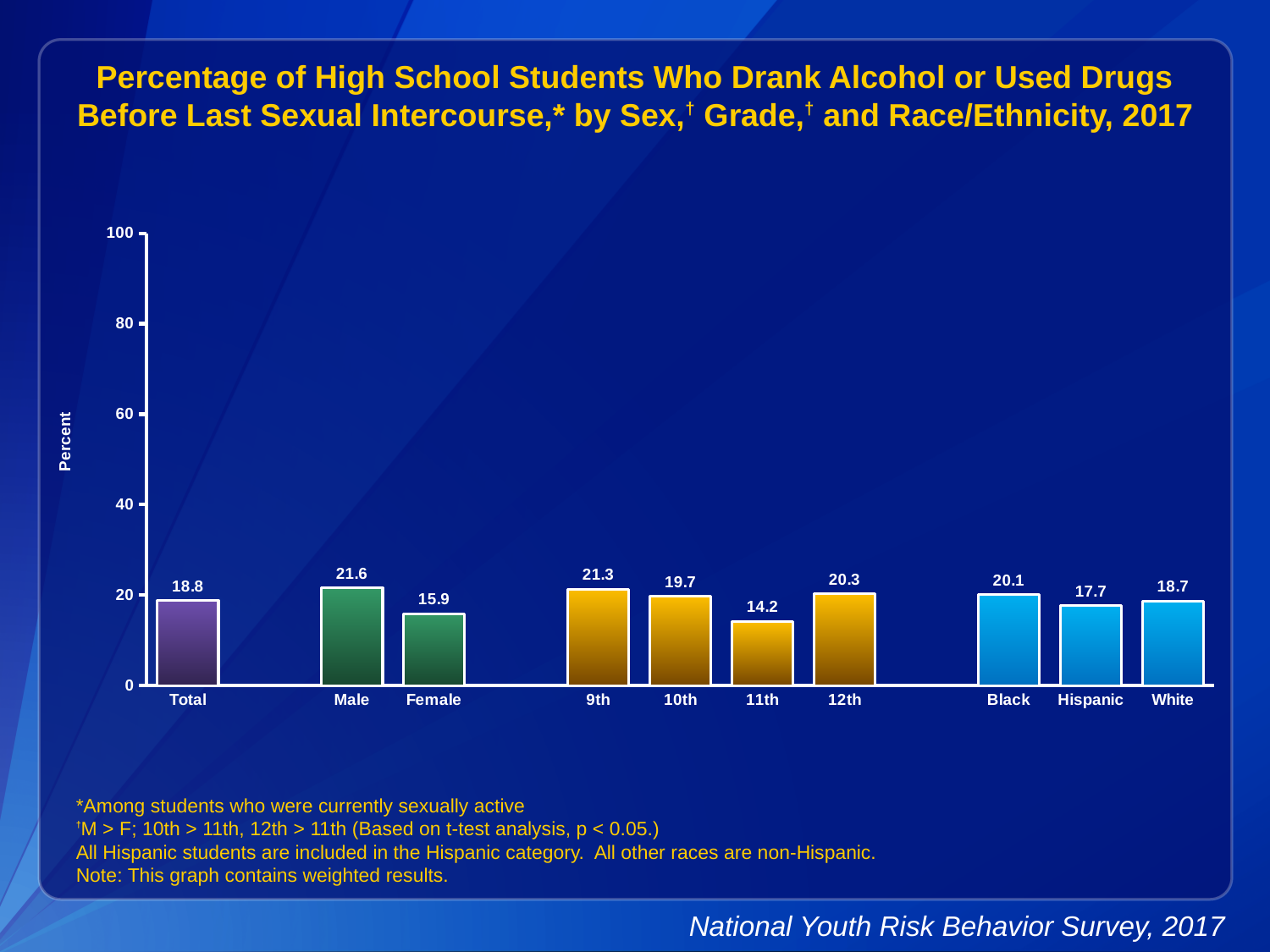
Which category has the lowest value? 11th What is the value for Hispanic students? 17.7 What is the value for Total? 18.8 What is the difference between the Male and Female values? 5.7 What is the value for Female? 15.9 Is the value for 12th grade greater or less than 40? less What is the label on the y axis? Percent Which category has the highest value? Male What is the value for 11th grade? 14.2 How many categories are shown on the x axis? 10 Which is larger, the value for Black or the value for White? Black What kind of chart is this? bar chart